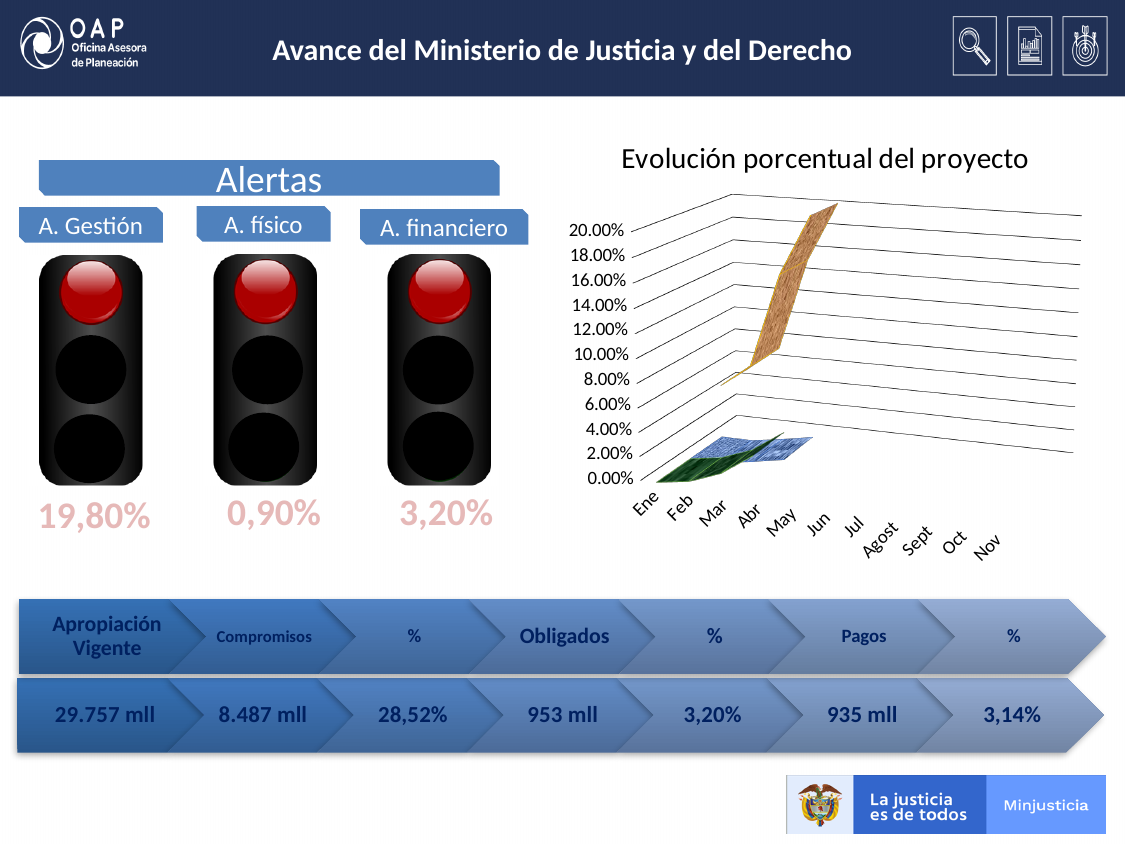
What is the first category on the x axis of the 'Evolución porcentual del proyecto' chart? Ene What is the title of the chart on the right side of the slide? Evolución porcentual del proyecto Which month comes immediately after 'Jul' on the x axis of the 'Evolución porcentual del proyecto' chart? Agost What is the highest value shown on the vertical axis of the 'Evolución porcentual del proyecto' chart? 20.00% How many month categories are shown on the x axis of the 'Evolución porcentual del proyecto' chart? 11 What is the last category on the x axis of the 'Evolución porcentual del proyecto' chart? Nov What is the lowest value shown on the vertical axis of the 'Evolución porcentual del proyecto' chart? 0.00% In the 'Evolución porcentual del proyecto' chart, what is the interval between consecutive tick marks on the vertical axis? 2.00%